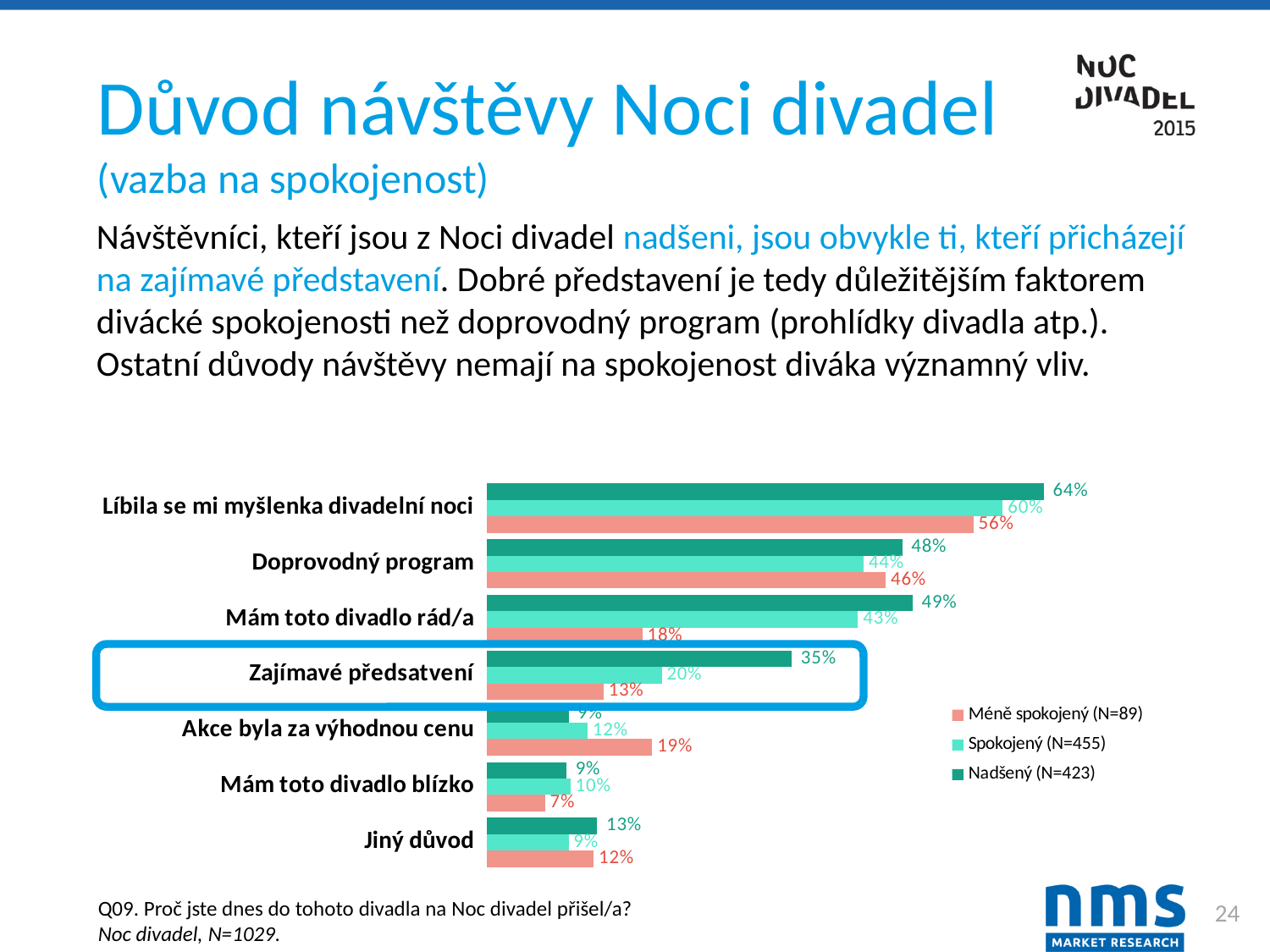
How many categories (reasons for visiting) are shown in the chart? 7 Which category has the lowest value for the 'Méně spokojený' series? Mám toto divadlo blízko What is the value for 'Spokojený' in the category 'Líbila se mi myšlenka divadelní noci'? 60% What is the value for 'Nadšený' in the category 'Zajímavé předsatvení'? 35% What is the value for 'Méně spokojený' in the category 'Mám toto divadlo rád/a'? 18% Which category has the highest value for the 'Nadšený' series? Líbila se mi myšlenka divadelní noci What is the difference between the 'Nadšený' and 'Méně spokojený' values for 'Zajímavé předsatvení'? 22 percentage points How many series does the legend list? 3 What kind of chart is shown on the slide? bar chart What is the difference between the 'Nadšený' and 'Spokojený' values for 'Doprovodný program'? 4 percentage points What is the sample size (N) shown in the legend for the 'Spokojený' series? N=455 In the category 'Akce byla za výhodnou cenu', which is larger: the 'Spokojený' value or the 'Méně spokojený' value? Méně spokojený